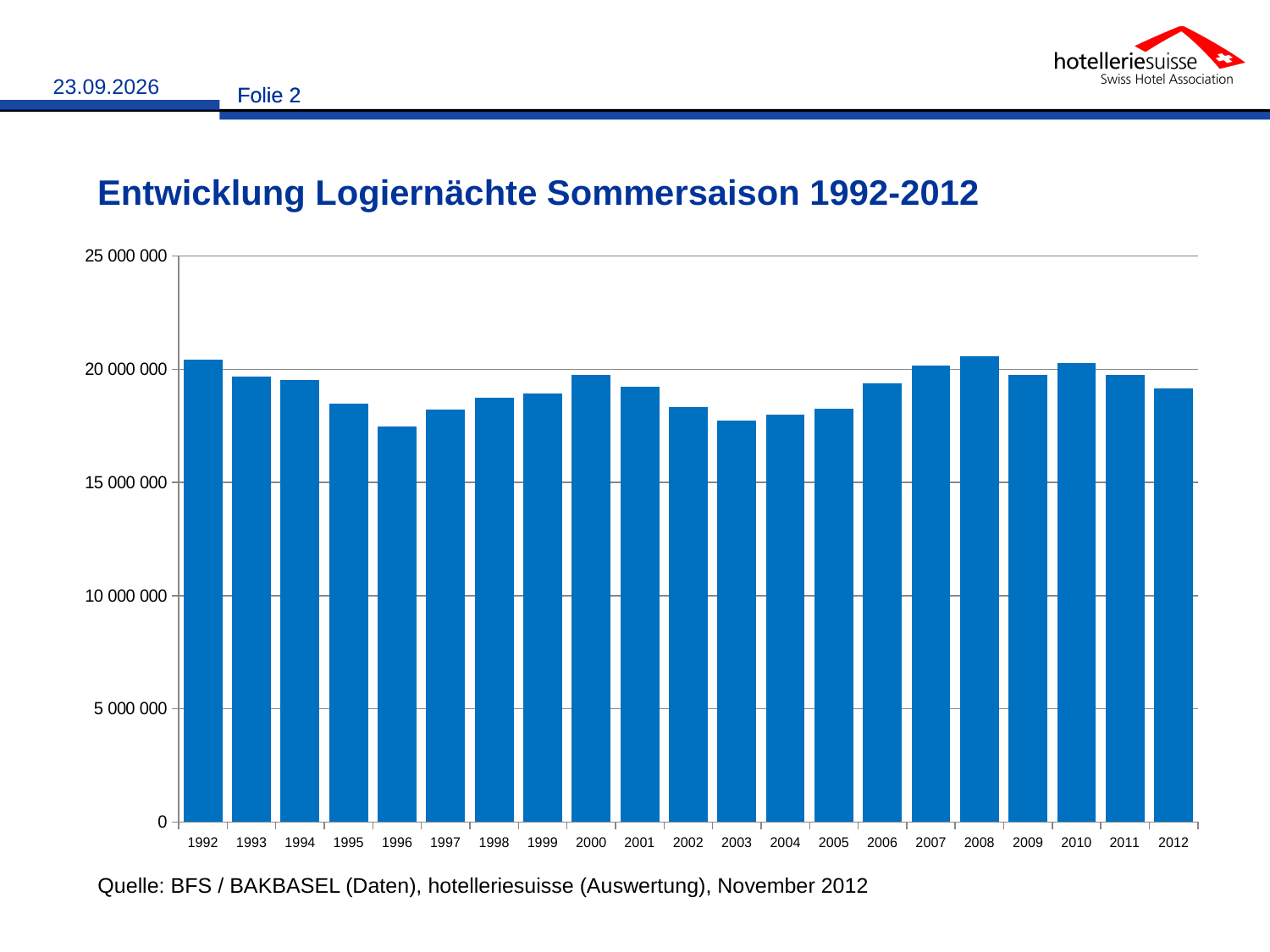
Is the value for 2012 greater or less than 20 000 000? less Is the value for 1992 greater or less than 20 000 000? greater What is the title of the chart? Entwicklung Logiernächte Sommersaison 1992-2012 Which year has the larger value, 1992 or 1996? 1992 Which year has the larger value, 2008 or 2003? 2008 Which year has the highest number of Logiernächte in the chart? 2008 Is the value for 1996 greater or less than 20 000 000? less How many years (bars) are plotted in the chart? 21 Do the values rise or fall from 2003 to 2008? rise Do the values rise or fall from 1992 to 1996? fall What kind of chart is shown on the slide? bar chart